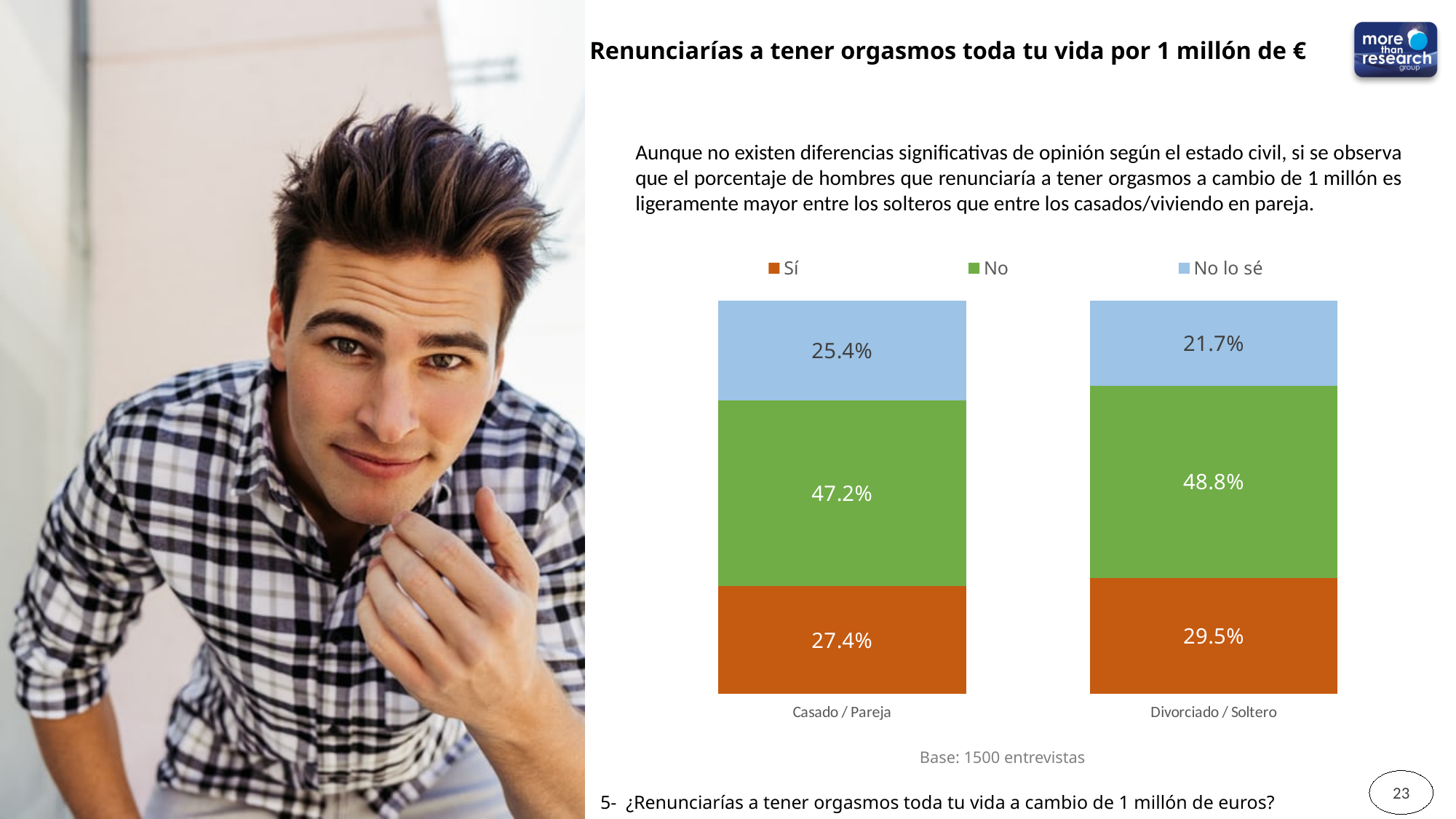
What percentage of Casado / Pareja respondents answered Sí? 27.4% What is the difference between the Sí percentages for Divorciado / Soltero and Casado / Pareja? 2.1% What percentage of Divorciado / Soltero respondents answered No? 48.8% Which response has the largest share among Casado / Pareja respondents? No What type of chart is shown on the slide? Stacked bar chart How many categories are shown on the x axis? 2 What is the No lo sé value for Divorciado / Soltero? 21.7% What is the difference between the No lo sé percentages for Casado / Pareja and Divorciado / Soltero? 3.7% Which group has the higher Sí percentage, Casado / Pareja or Divorciado / Soltero? Divorciado / Soltero Which response has the smallest share among Divorciado / Soltero respondents? No lo sé How many series does the legend list? 3 What is the No lo sé value for Casado / Pareja? 25.4%